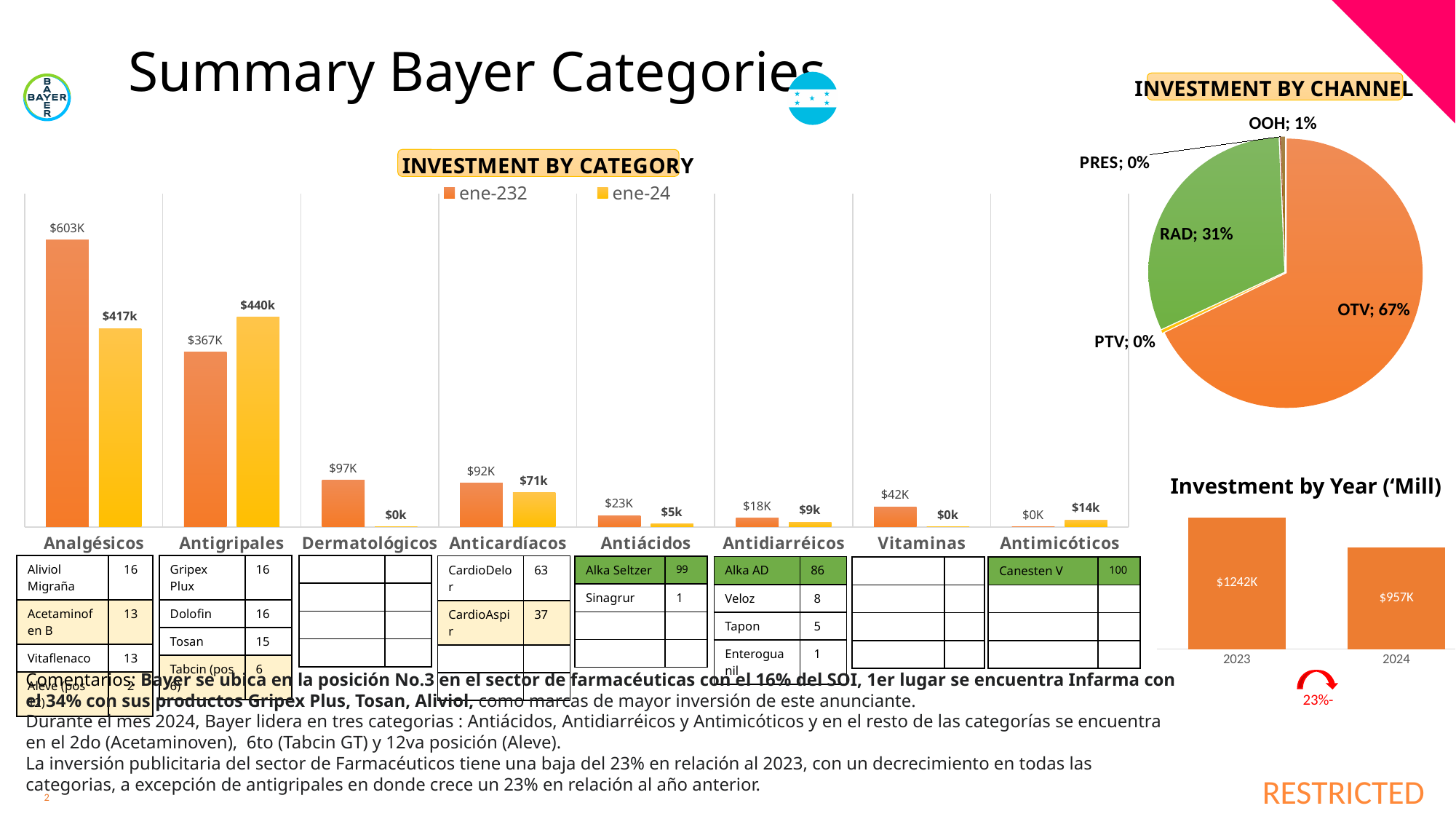
In the INVESTMENT BY CATEGORY chart, which category has the highest ene-232 value? Analgésicos In the INVESTMENT BY CHANNEL pie chart, what share does RAD have? 31% In the INVESTMENT BY CATEGORY chart, how many categories are shown on the x axis? 8 In the INVESTMENT BY CATEGORY chart, which category has the highest ene-24 value? Antigripales In the INVESTMENT BY CHANNEL pie chart, what share does OTV have? 67% In the INVESTMENT BY CATEGORY chart, how many series does the legend list? 2 In the INVESTMENT BY CATEGORY chart, what is the ene-232 value for Analgésicos? $603K In the Investment by Year ('Mill) chart, what is the value for 2024? $957K In the Investment by Year ('Mill) chart, what is the difference between the 2023 and 2024 values? $285K In the INVESTMENT BY CATEGORY chart, which is larger for Anticardíacos: the ene-232 value or the ene-24 value? ene-232 In the INVESTMENT BY CHANNEL pie chart, how many slices are labelled? 5 In the INVESTMENT BY CATEGORY chart, what is the ene-24 value for Antigripales? $440k